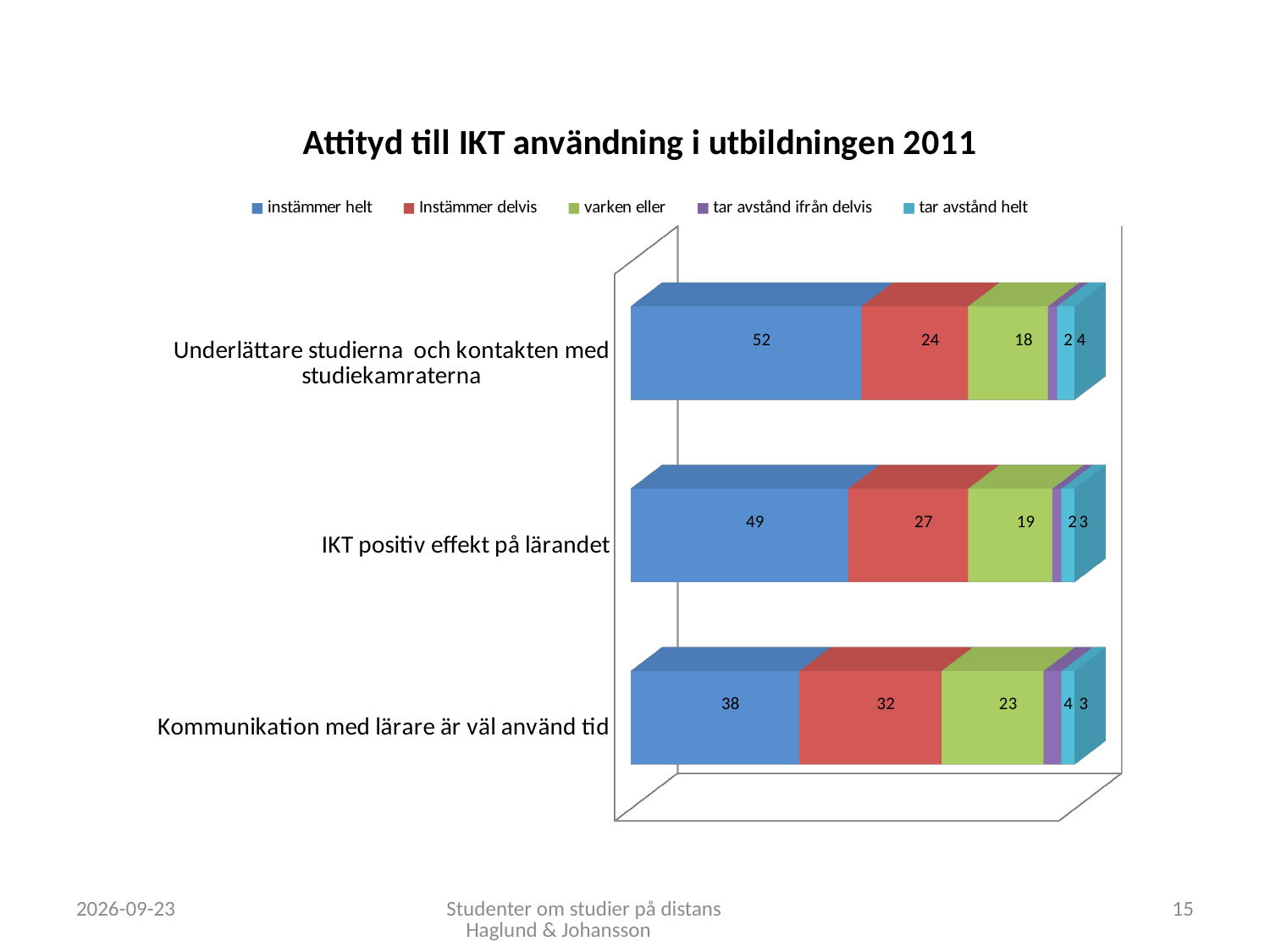
How many categories are shown on the chart? 3 What is the title of the chart? Attityd till IKT användning i utbildningen 2011 Which is larger: the "Instämmer delvis" value for "IKT positiv effekt på lärandet" or for "Kommunikation med lärare är väl använd tid"? Kommunikation med lärare är väl använd tid What is the value for "varken eller" for "IKT positiv effekt på lärandet"? 19 How many series does the legend list? 5 What is the total of the stacked bar for "IKT positiv effekt på lärandet"? 100 Which category has the highest value for "instämmer helt"? Underlättare studierna och kontakten med studiekamraterna What is the value for "instämmer helt" for "Underlättare studierna och kontakten med studiekamraterna"? 52 What kind of chart is shown on the slide? Stacked bar chart What is the difference between the "instämmer helt" values for "Underlättare studierna och kontakten med studiekamraterna" and "Kommunikation med lärare är väl använd tid"? 14 Which category has the lowest value for "instämmer helt"? Kommunikation med lärare är väl använd tid What is the value for "Instämmer delvis" for "Kommunikation med lärare är väl använd tid"? 32